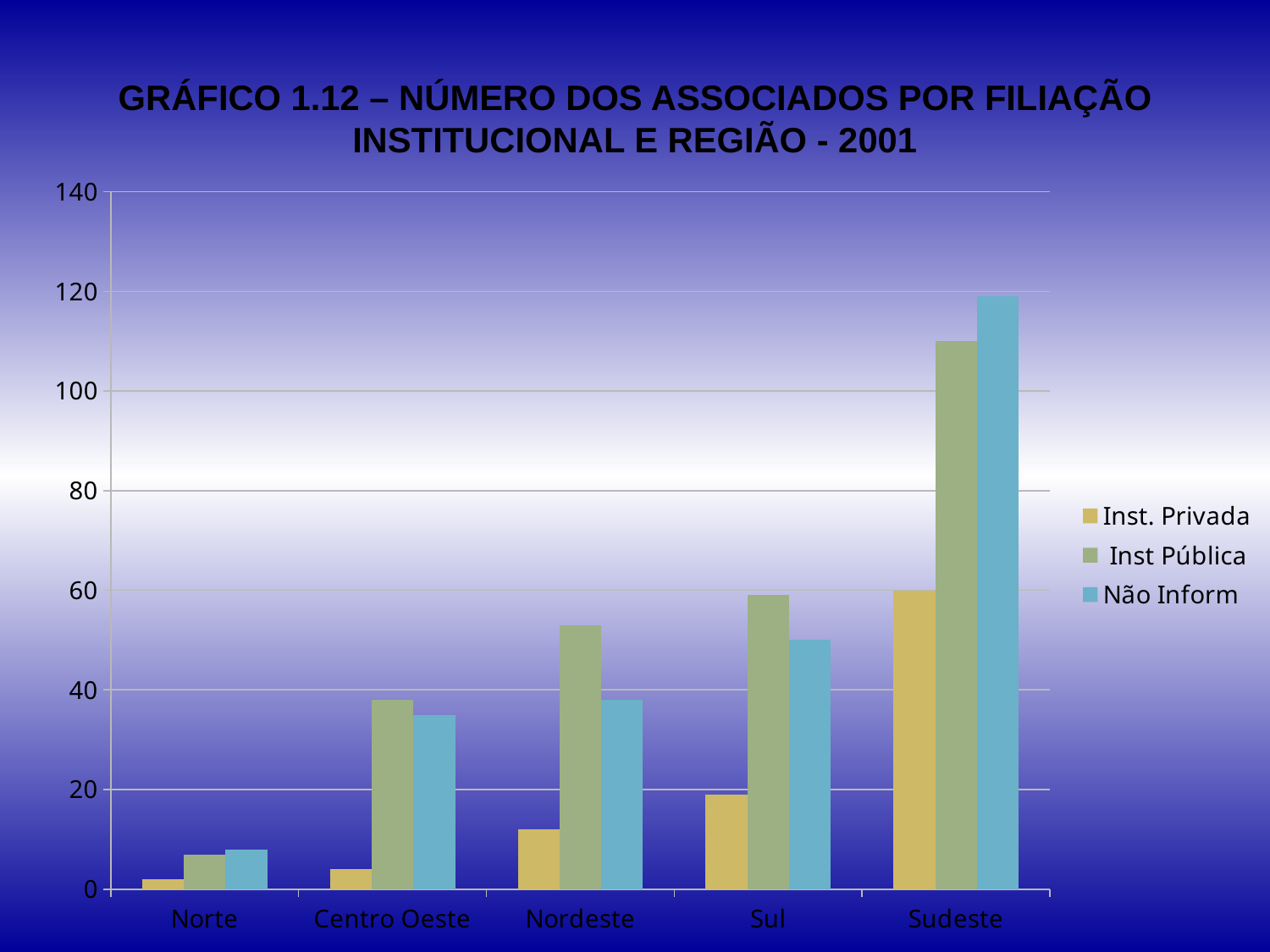
What kind of chart is shown on the slide? bar chart Is the value for Não Inform in Sul greater or less than 60? less Which region has the lowest value for Inst. Privada? Norte Is the value for Inst. Privada in Nordeste greater or less than 20? less Is the value for Inst Pública in Sudeste greater or less than 100? greater Do the Inst. Privada values rise or fall from Norte to Sudeste along the x axis? rise Which region has the highest value for Não Inform? Sudeste How many regions are shown on the x axis? 5 What year is given in the chart title? 2001 How many series does the legend list? 3 Which is larger in Nordeste: Inst. Privada or Não Inform? Não Inform Which is larger in Sul: Inst Pública or Não Inform? Inst Pública